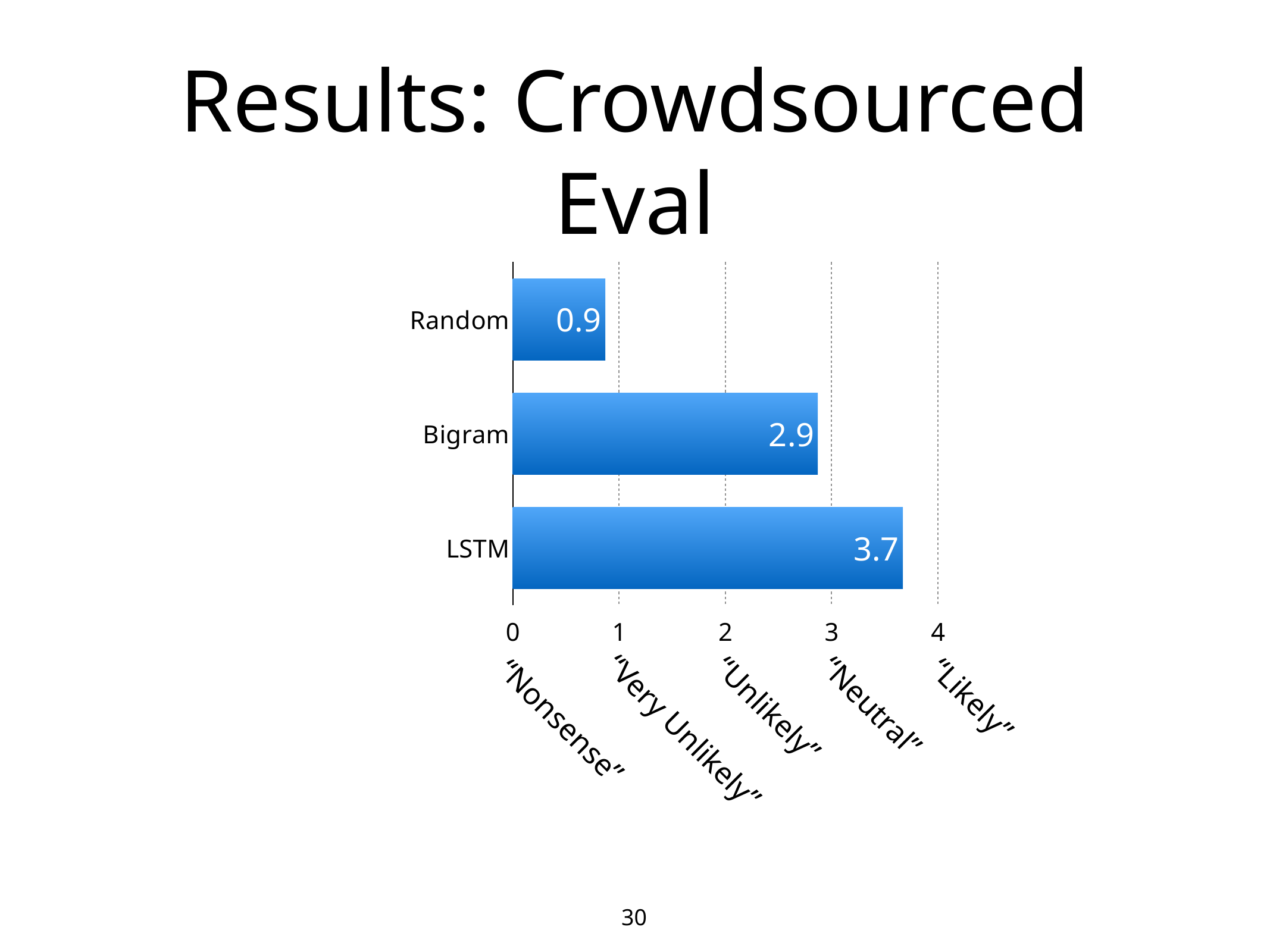
What is the value for Random? 0.9 What is the difference between the values for Bigram and Random? 2 What is the difference between the values for LSTM and Bigram? 0.8 What label on the x axis corresponds to the tick value 4? "Likely" Which category has the highest value? LSTM How many categories are shown in the chart? 3 Which category has the lowest value? Random What is the value for Bigram? 2.9 Which has a larger value, Bigram or Random? Bigram Is the value for LSTM greater or less than 3? greater What kind of chart is shown on the slide? bar chart What is the value for LSTM? 3.7